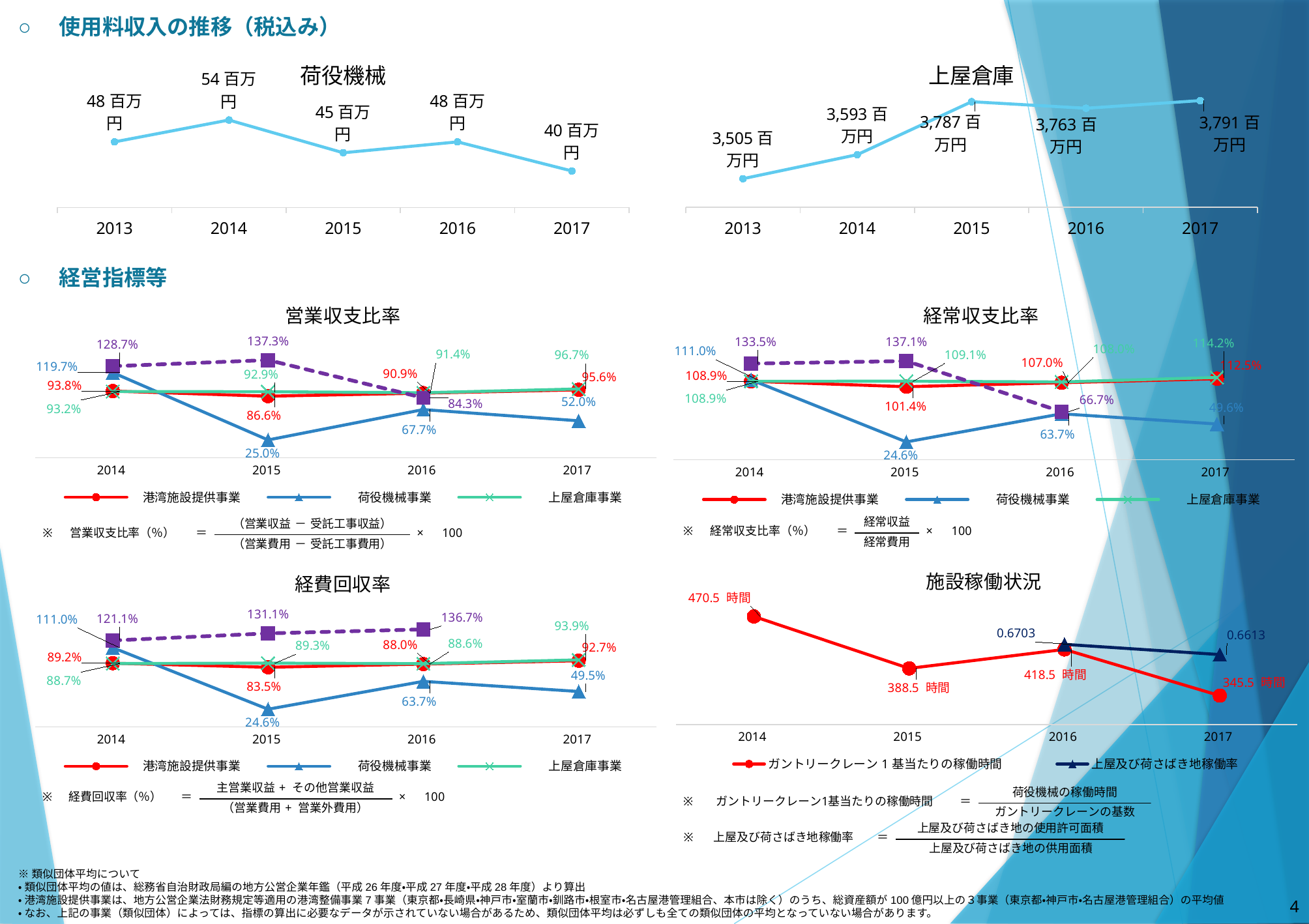
In the 営業収支比率 chart, which series has the highest value in 2017? 上屋倉庫事業 In the 荷役機械 chart, what is the value for 2014? 54 百万円 In the 経費回収率 chart, is the value for 荷役機械事業 in 2014 larger or smaller than the value for 港湾施設提供事業 in 2014? larger In the 施設稼働状況 chart, what is the value for ガントリークレーン１基当たりの稼働時間 in 2015? 388.5 時間 In the 上屋倉庫 chart, what is the difference between the 2015 and 2014 values? 194 百万円 In the 営業収支比率 chart, what is the value for 荷役機械事業 in 2015? 25.0% How many data points are plotted in the 上屋倉庫 chart? 5 In the 経常収支比率 chart, what is the value for 港湾施設提供事業 in 2016? 107.0% In the 上屋倉庫 chart, what is the value for 2013? 3,505 百万円 How many series does the legend of the 経常収支比率 chart list? 3 What type of chart is the 施設稼働状況 chart? line chart In the 荷役機械 chart, which year has the lowest value? 2017